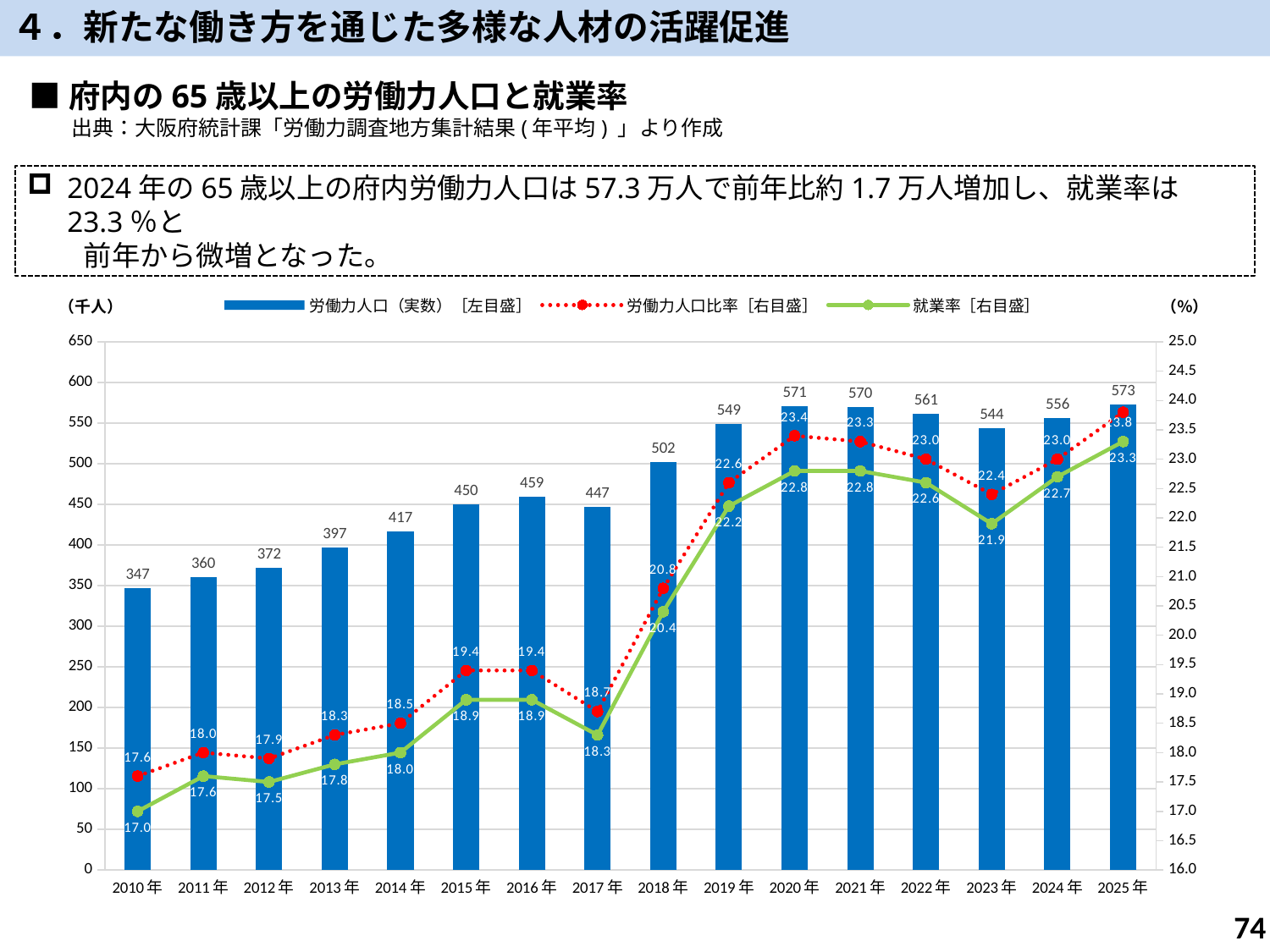
What is the value of 労働力人口（実数） for 2018年? 502 Does the 労働力人口（実数） series rise or fall from 2010年 to 2016年? rise What is the 就業率 value for 2023年? 21.9 Which is larger, the 労働力人口（実数） value for 2016年 or for 2017年? 2016年 How many series does the legend list? 3 What is the 労働力人口比率 value for 2020年? 23.4 Which year has the highest 労働力人口（実数） bar? 2025年 Which year has the lowest 就業率 value? 2010年 How many years are shown on the x axis? 16 What kind of chart is this? Combined bar and line chart What is the difference between the 労働力人口（実数） values for 2025年 and 2024年? 17 Is the 労働力人口（実数） value for 2013年 greater or less than 400? less